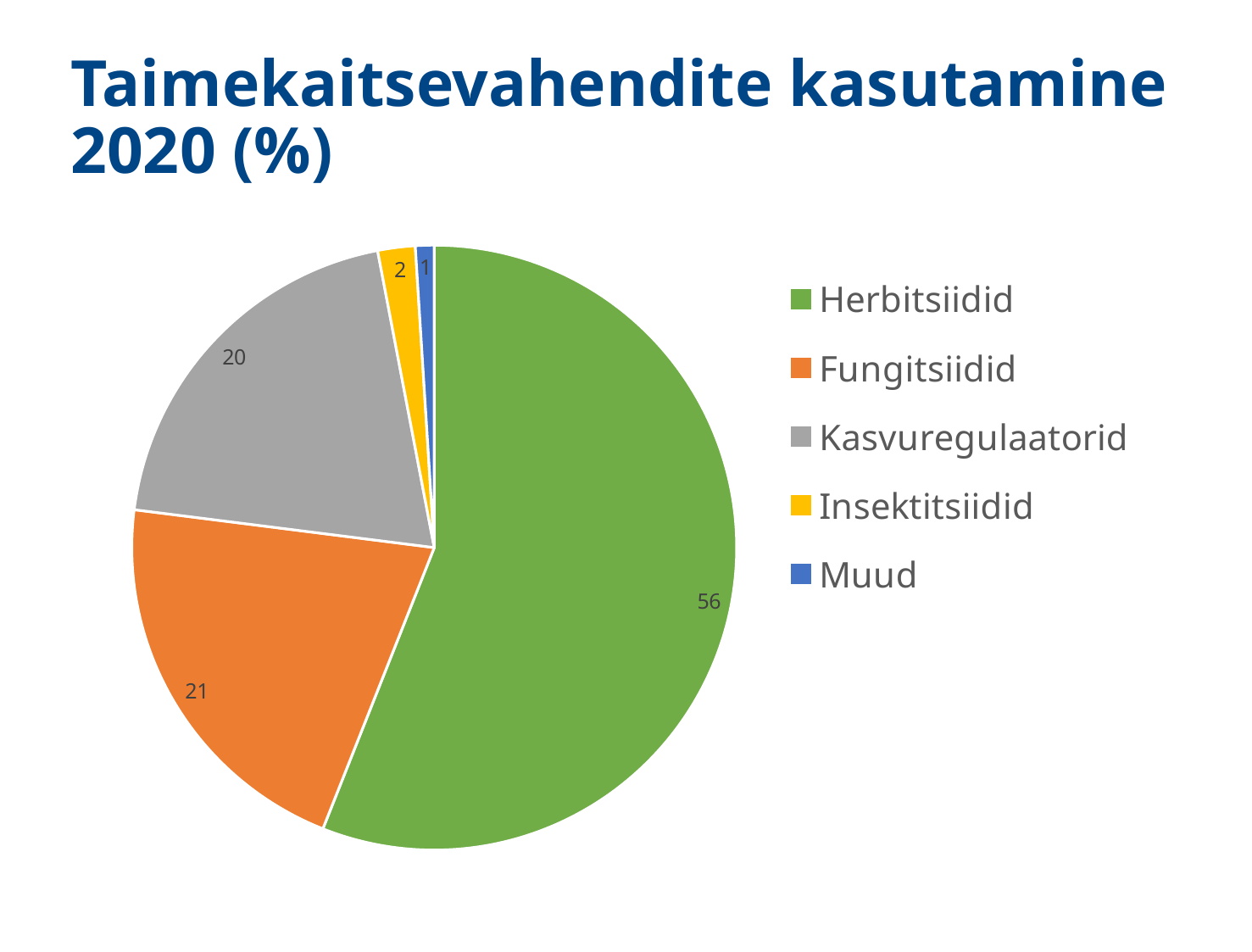
What is the difference between the values for Herbitsiidid and Fungitsiidid? 35 What is the value for Fungitsiidid? 21 Which is larger, Fungitsiidid or Kasvuregulaatorid? Fungitsiidid What is the title of the chart? Taimekaitsevahendite kasutamine 2020 (%) What is the value for Herbitsiidid? 56 What is the value for Insektitsiidid? 2 What is the value for Muud? 1 What is the value for Kasvuregulaatorid? 20 Which category has the smallest slice? Muud What type of chart is shown on the slide? pie chart How many categories does the pie chart have? 5 Which category has the largest slice? Herbitsiidid